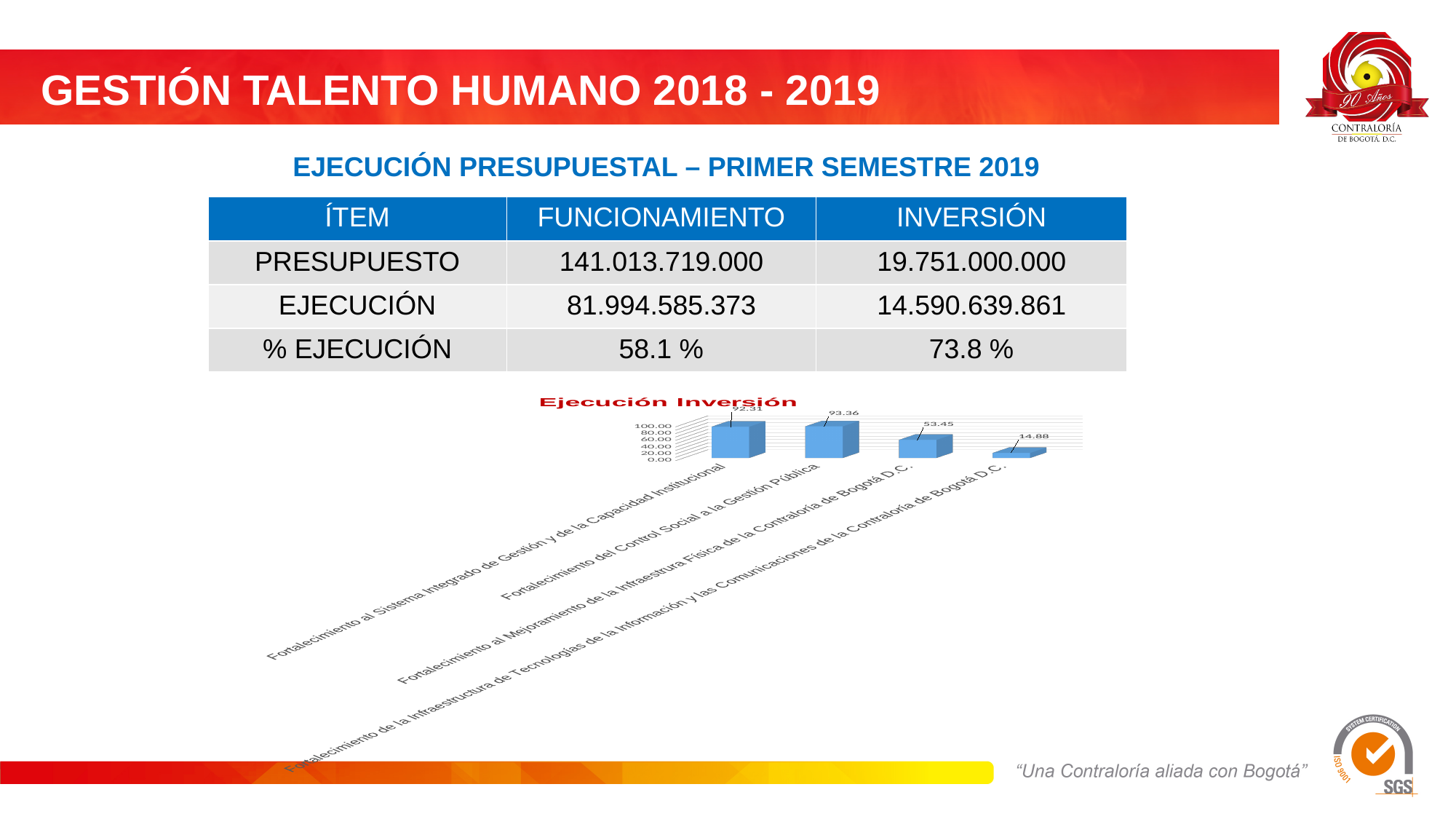
In the Ejecución Inversión chart, which is larger: the value for 'Fortalecimiento al Sistema Integrado de Gestión y de la Capacidad Institucional' or the value for 'Fortalecimiento al Mejoramiento de la Infraestructura Física de la Contraloría de Bogotá D.C.'? Fortalecimiento al Sistema Integrado de Gestión y de la Capacidad Institucional How many categories are shown in the Ejecución Inversión chart? 4 What is the value for 'Fortalecimiento del Control Social a la Gestión Pública' in the Ejecución Inversión chart? 93.36 In the Ejecución Inversión chart, what is the difference between the value for 'Fortalecimiento del Control Social a la Gestión Pública' and the value for 'Fortalecimiento al Mejoramiento de la Infraestructura Física de la Contraloría de Bogotá D.C.'? 39.91 In the Ejecución Inversión chart, is the value for 'Fortalecimiento de la Infraestructura de Tecnologías de la Información y las Comunicaciones de la Contraloría de Bogotá D.C.' greater or less than 20.00? less Which category has the highest value in the Ejecución Inversión chart? Fortalecimiento del Control Social a la Gestión Pública What is the title of the chart on the slide? Ejecución Inversión What kind of chart is the Ejecución Inversión chart? Bar chart What is the value for 'Fortalecimiento al Mejoramiento de la Infraestructura Física de la Contraloría de Bogotá D.C.' in the Ejecución Inversión chart? 53.45 What is the value for 'Fortalecimiento de la Infraestructura de Tecnologías de la Información y las Comunicaciones de la Contraloría de Bogotá D.C.' in the Ejecución Inversión chart? 14.88 What is the value for 'Fortalecimiento al Sistema Integrado de Gestión y de la Capacidad Institucional' in the Ejecución Inversión chart? 92.31 Which category has the lowest value in the Ejecución Inversión chart? Fortalecimiento de la Infraestructura de Tecnologías de la Información y las Comunicaciones de la Contraloría de Bogotá D.C.